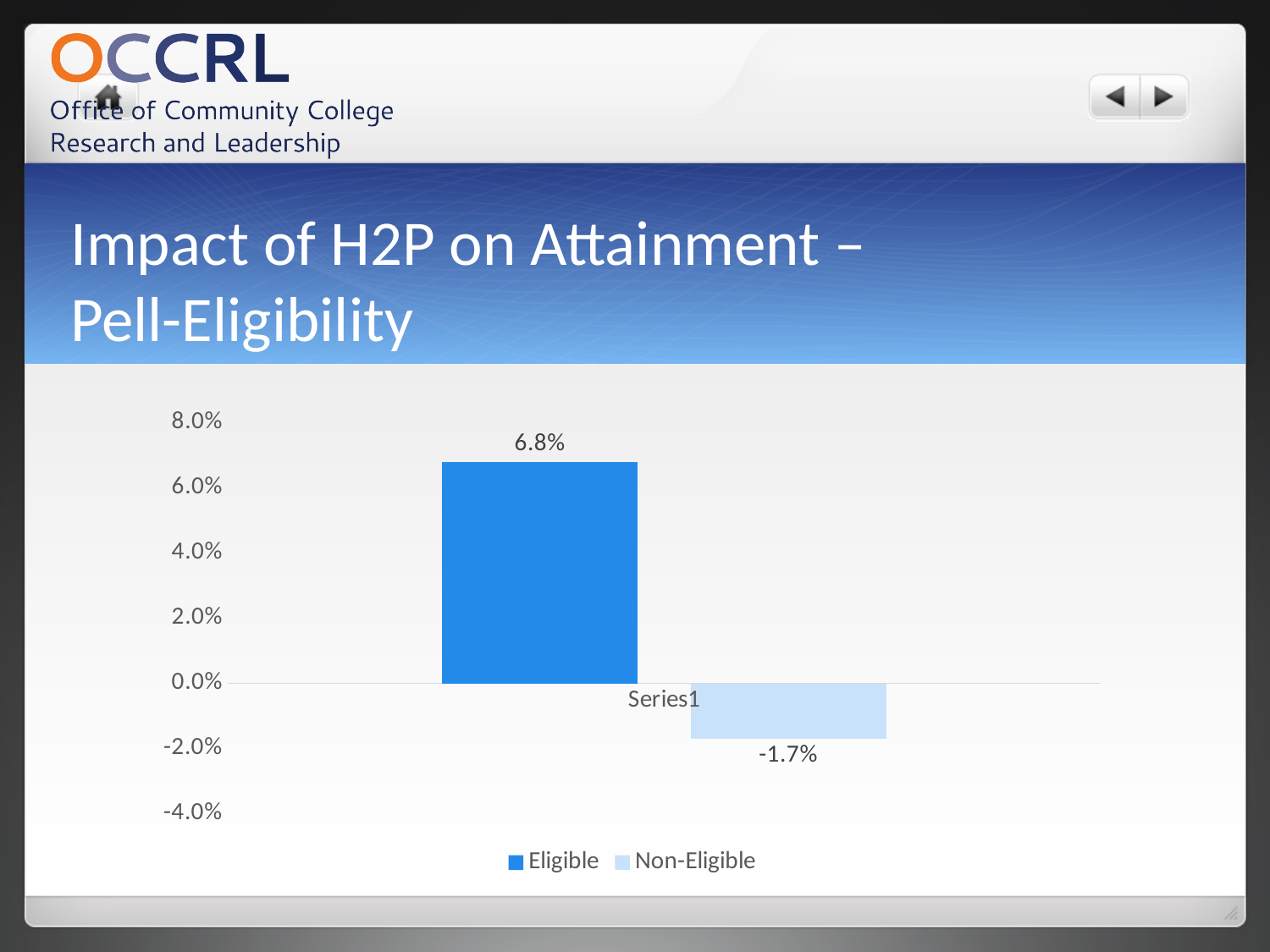
Which series has the lowest value? Non-Eligible What is the difference between the Eligible and Non-Eligible values? 8.5% Is the value for Eligible greater or less than 6.0%? greater What is the value for Non-Eligible? -1.7% What is the category label shown on the x axis? Series1 What kind of chart is shown on the slide? bar chart What is the value for Eligible? 6.8% What is the highest value shown on the y axis? 8.0% How many series does the legend list? 2 Which series has the higher value, Eligible or Non-Eligible? Eligible Is the value for Non-Eligible greater or less than 0.0%? less